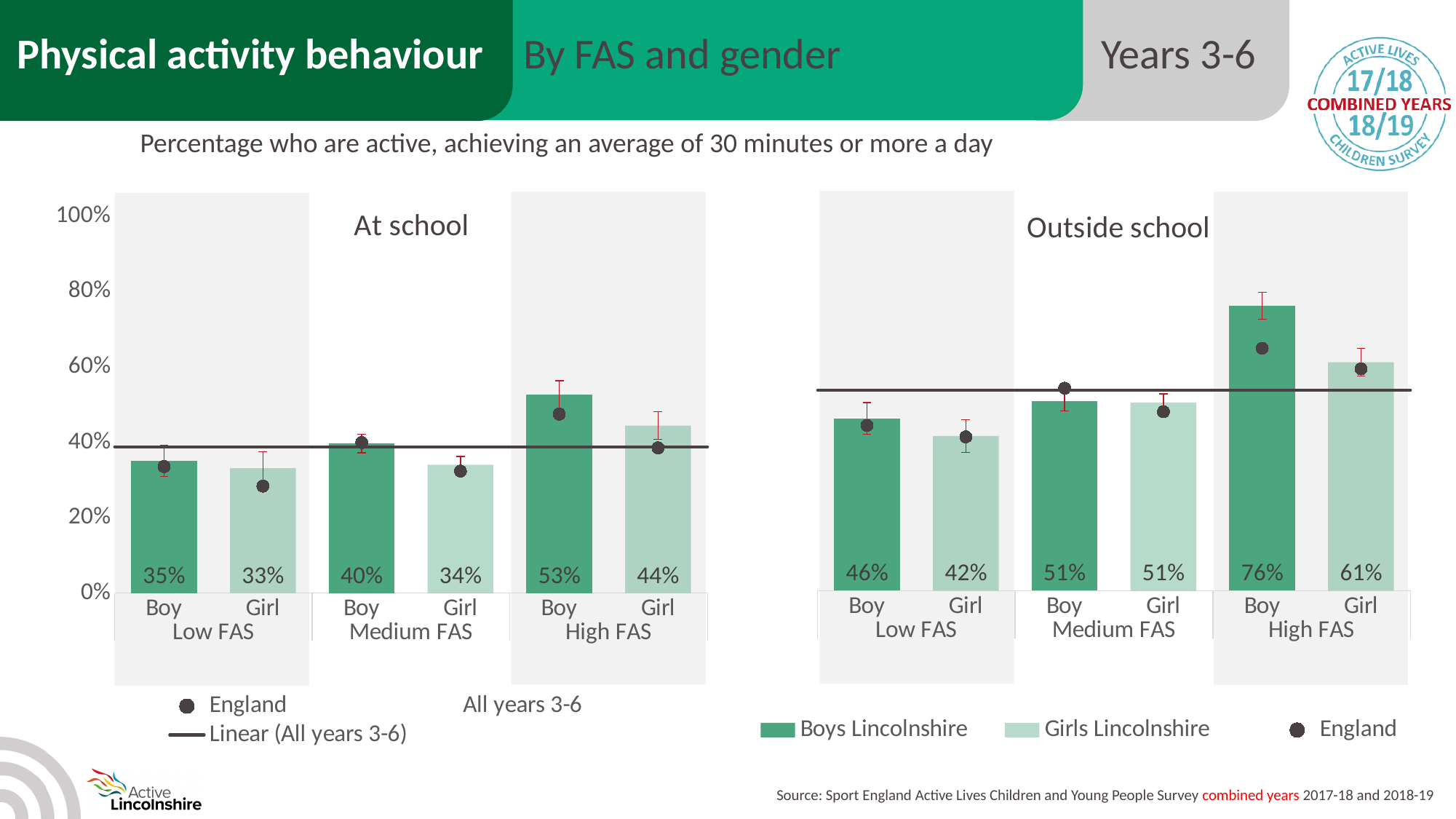
How many bars are plotted in the 'At school' chart? 6 In the 'Outside school' chart, which bar has the highest value? High FAS Boy In the 'Outside school' chart, is the value for High FAS girls greater or less than 60%? greater In the 'At school' chart, what is the difference between the High FAS boys and High FAS girls values? 9% What type of chart is used for the 'Outside school' data? Bar chart In the 'At school' chart, what is the value for High FAS boys? 53% In the 'At school' chart, which bar has the lowest value? Low FAS Girl In the 'At school' chart, which is larger: the Medium FAS boys value or the Low FAS boys value? Medium FAS boys In the 'Outside school' chart, what is the difference between the High FAS boys and Low FAS boys values? 30% In the 'Outside school' chart, do the boys' values rise or fall from Low FAS to High FAS? Rise In the 'Outside school' chart, what is the value for Low FAS girls? 42% In the 'Outside school' chart, which is larger: the Medium FAS boys value or the Medium FAS girls value? They are equal (51%)